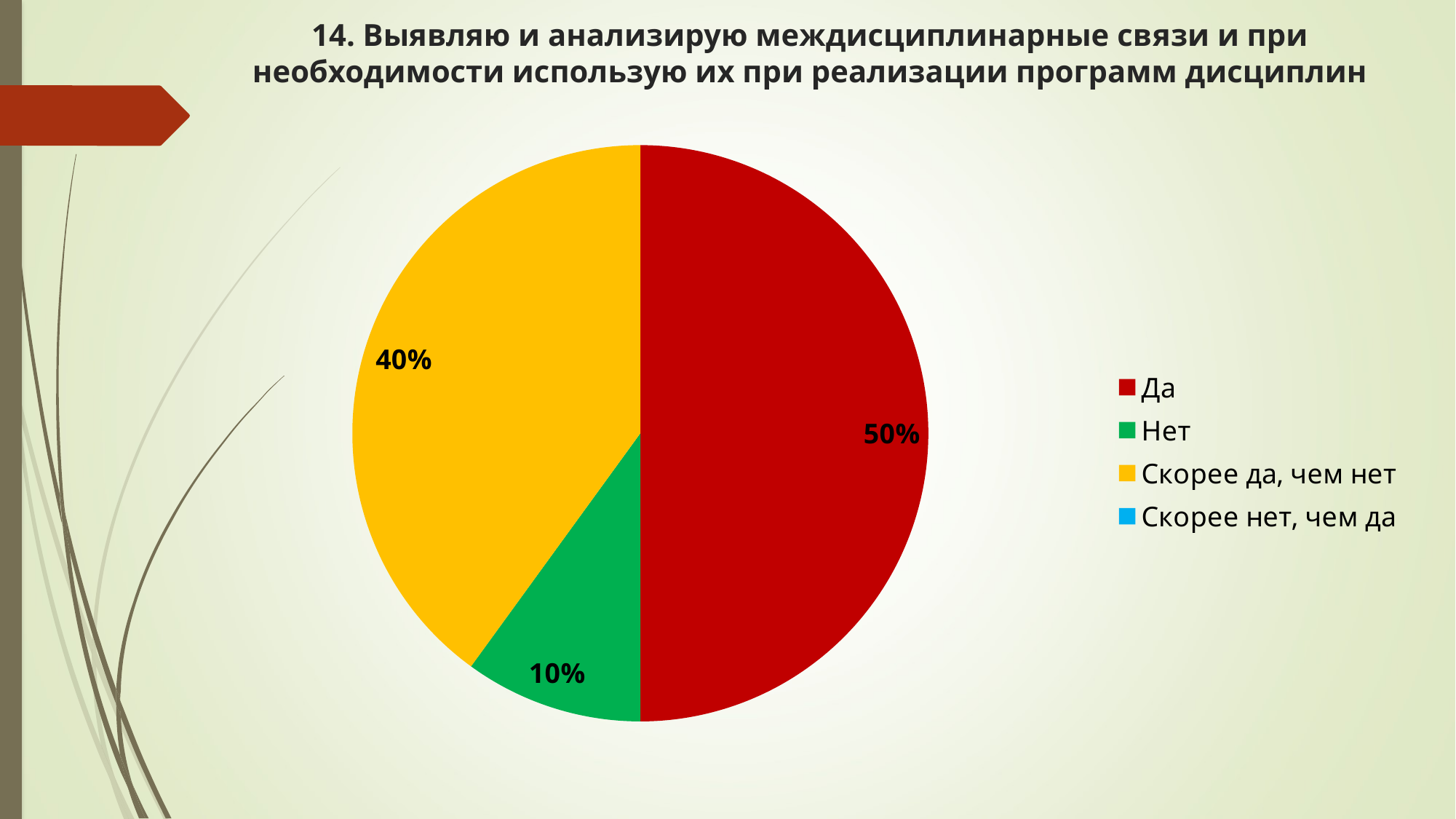
Which is larger: the "Скорее да, чем нет" slice or the "Нет" slice? Скорее да, чем нет What percentage of the pie is the "Нет" slice? 10% What percentage of the pie is the "Скорее да, чем нет" slice? 40% What percentage of the pie is the "Да" slice? 50% How many entries does the legend list? 4 What is the difference between the "Да" share and the "Нет" share? 40% What colour is the "Да" slice? red What kind of chart is shown on the slide? pie chart Which category with a visible slice has the smallest share of the pie? Нет Which legend entry has no visible slice in the pie? Скорее нет, чем да What is the difference between the "Да" share and the "Скорее да, чем нет" share? 10% Which category has the largest slice of the pie? Да